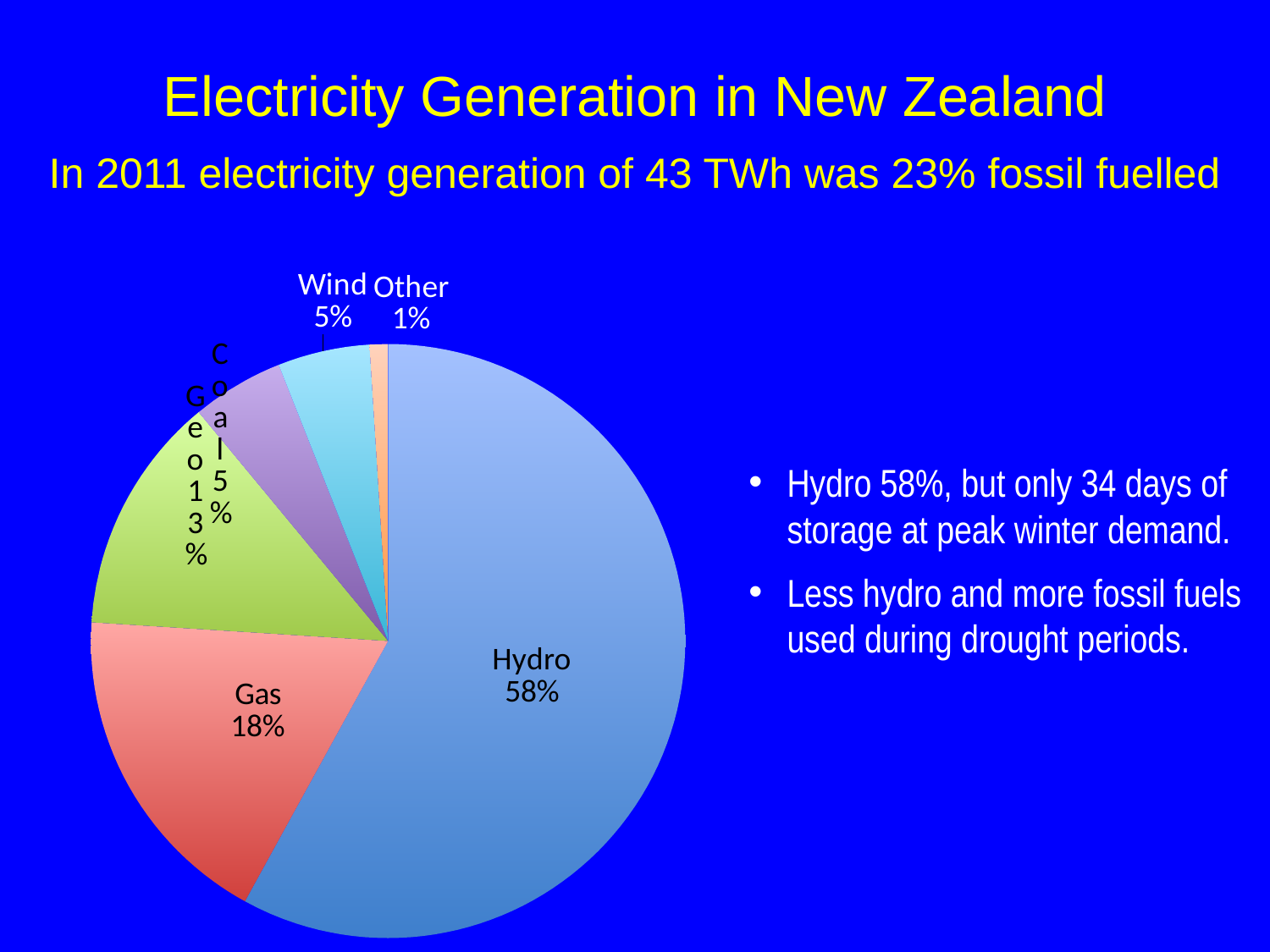
What percentage is shown for Wind in the pie chart? 5% Which category has the smallest slice of the pie chart? Other What percentage is shown for Gas in the pie chart? 18% What share of electricity generation does Hydro account for in the pie chart? 58% What kind of chart is shown on the slide? pie chart Which category has the largest slice of the pie chart? Hydro By how many percentage points does Hydro exceed Gas in the pie chart? 40 How many slices does the pie chart have? 6 What is the combined share of Gas and Coal in the pie chart? 23% Which is larger in the pie chart, Gas or Geo? Gas What percentage is shown for Other in the pie chart? 1% What percentage is shown for Geo in the pie chart? 13%